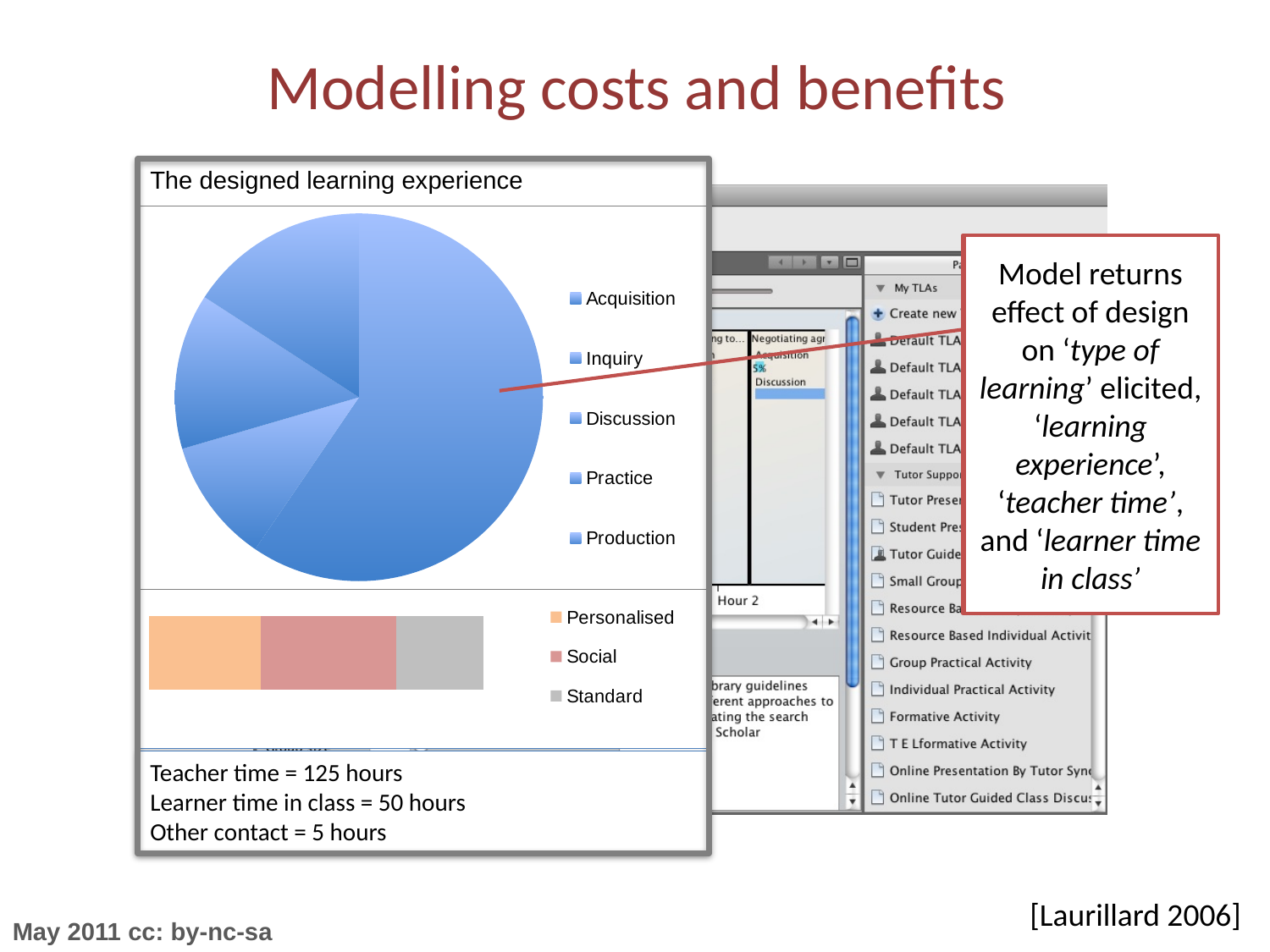
What kind of chart is the lower chart in the panel, below the pie chart? bar chart According to the text below the charts, what is the other contact time? 5 hours According to the text below the charts, what is the learner time in class? 50 hours How many categories does the legend of the pie chart list? 5 In the lower stacked bar chart, which segment is larger, Personalised or Standard? Personalised In the lower stacked bar chart, which colour represents the Social segment? pink/red How many series does the legend of the lower stacked bar chart list? 3 Which category has the largest slice in the pie chart? Acquisition What is the title of the panel containing the pie chart? The designed learning experience According to the text below the charts, what is the teacher time? 125 hours In the lower stacked bar chart, which segment is the smallest? Standard What kind of chart is the upper chart in the 'The designed learning experience' panel? pie chart